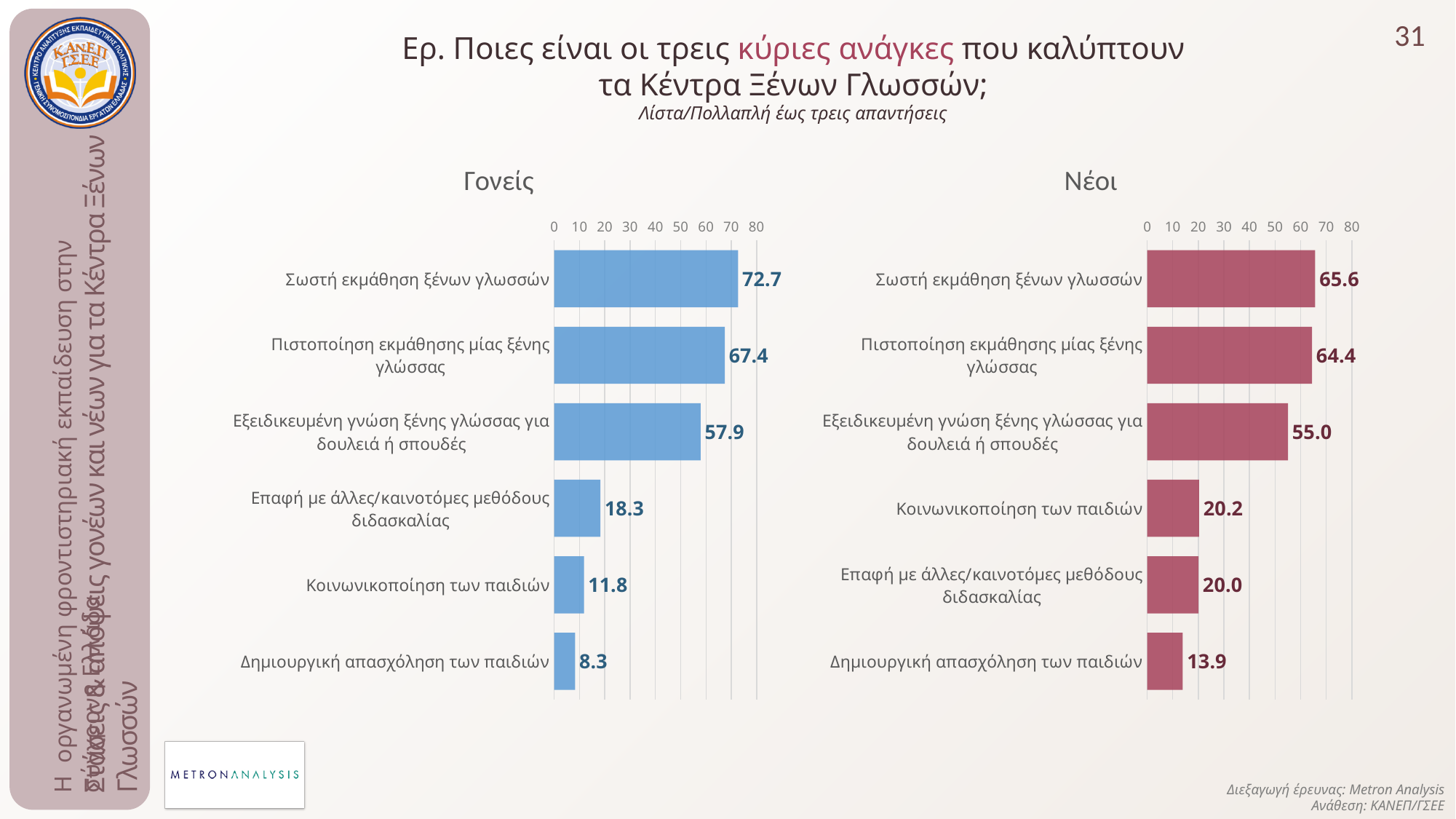
In the Γονείς chart, what is the value for Σωστή εκμάθηση ξένων γλωσσών? 72.7 In the Νέοι chart, which category has the highest value? Σωστή εκμάθηση ξένων γλωσσών Which is larger: the value for Κοινωνικοποίηση των παιδιών in the Γονείς chart or in the Νέοι chart? Νέοι In the Γονείς chart, which category has the lowest value? Δημιουργική απασχόληση των παιδιών How many categories does the Νέοι chart show? 6 In the Νέοι chart, what is the difference between Εξειδικευμένη γνώση ξένης γλώσσας για δουλειά ή σπουδές and Δημιουργική απασχόληση των παιδιών? 41.1 In the Γονείς chart, is the value for Εξειδικευμένη γνώση ξένης γλώσσας για δουλειά ή σπουδές greater or less than 50? greater In the Νέοι chart, what is the value for Επαφή με άλλες/καινοτόμες μεθόδους διδασκαλίας? 20.0 What kind of chart is the Γονείς chart? Bar chart In the Νέοι chart, what is the value for Πιστοποίηση εκμάθησης μίας ξένης γλώσσας? 64.4 In the Γονείς chart, what is the difference between Σωστή εκμάθηση ξένων γλωσσών and Πιστοποίηση εκμάθησης μίας ξένης γλώσσας? 5.3 What colour are the bars in the Νέοι chart? Red